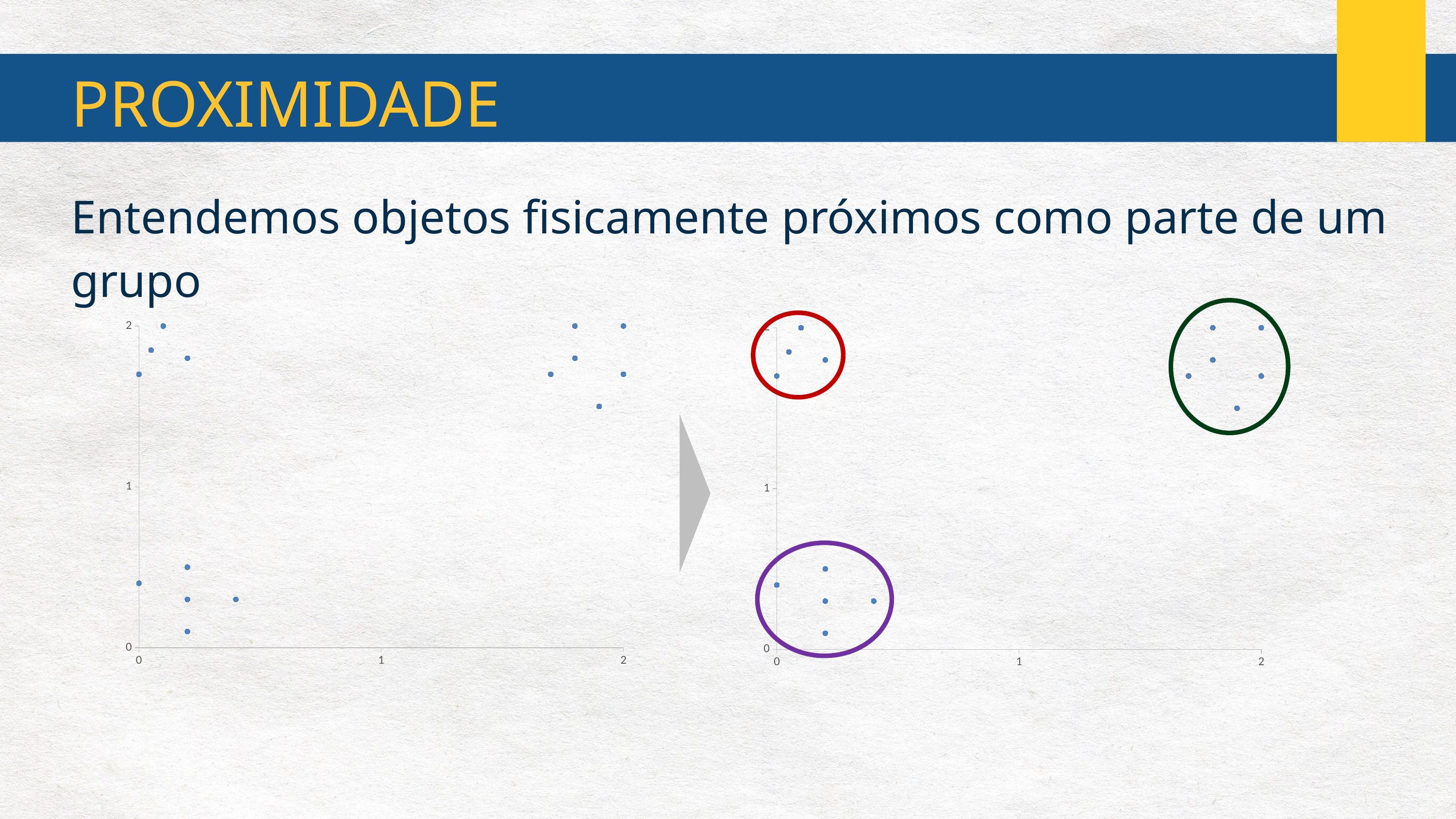
What colours are the three circles drawn on the right chart? red, green and purple In the right chart, how many points are inside the green circle? 6 In the left chart, what is the highest value shown on the x axis? 2 How many charts are on the slide? 2 In the right chart, are the x values of the points inside the green circle greater or less than 1? greater In the right chart, how many points are inside the purple circle? 5 In the right chart, are the y values of the points inside the green circle greater or less than 1? greater In the right chart, are the y values of the points inside the purple circle greater or less than 1? less What kind of chart is shown on the left of the slide? scatter chart